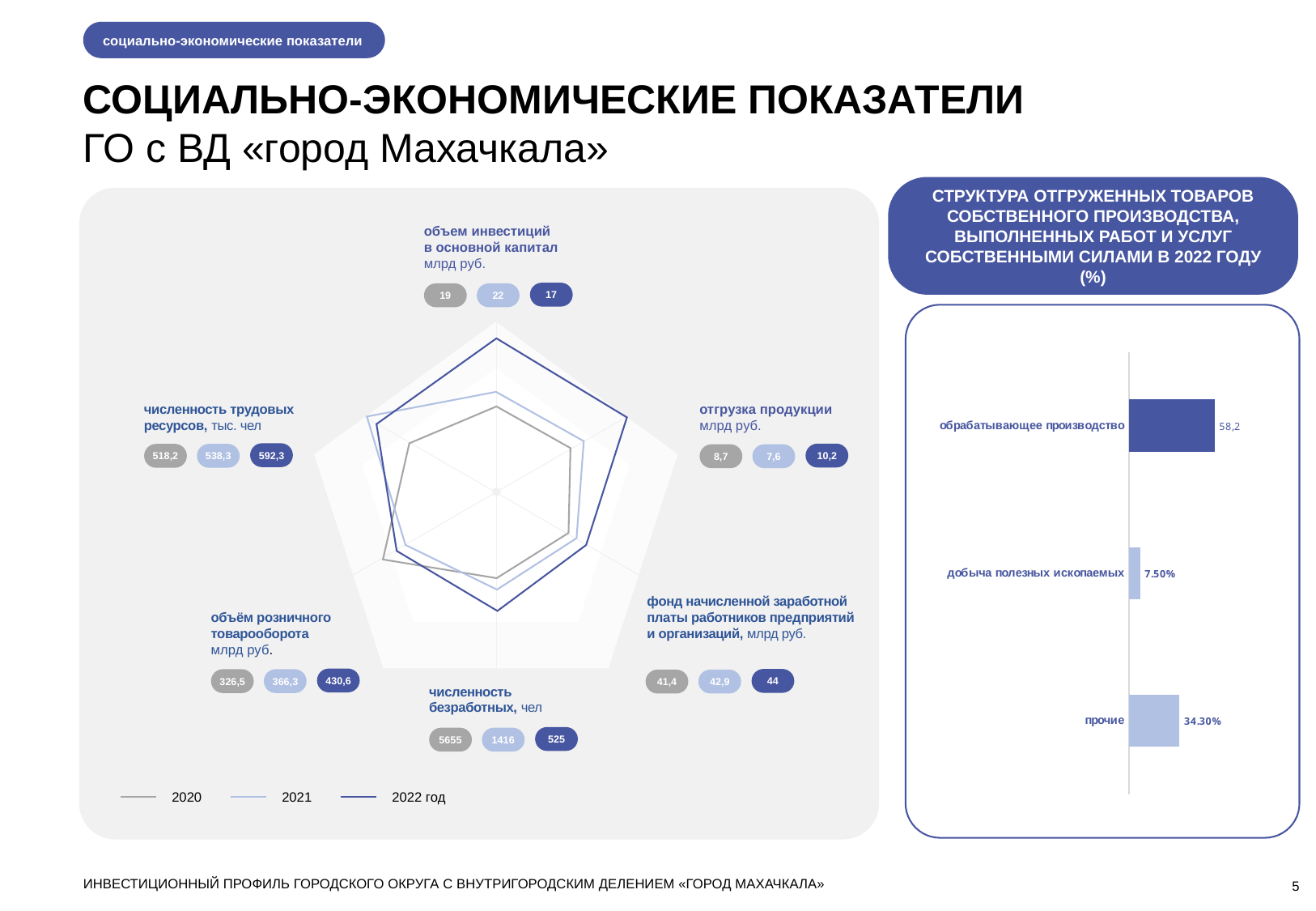
What kind of chart is the one on the right of the slide? bar chart On the right-hand bar chart, which category has the highest value? обрабатывающее производство What kind of chart is the one on the left of the slide? radar chart On the right-hand bar chart, what is the value for обрабатывающее производство? 58,2 How many categories are shown on the right-hand bar chart? 3 On the right-hand bar chart, what is the value for прочие? 34.30% How many indicators (axes) does the left-hand radar chart have? 6 On the left-hand radar chart, what is the value of численность безработных for 2022? 525 How many series does the legend of the left-hand radar chart list? 3 On the left-hand radar chart, what is the difference between the 2022 and 2020 values of объём розничного товарооборота? 104,1 On the right-hand bar chart, which category has the lowest value? добыча полезных ископаемых On the left-hand radar chart, does численность безработных rise or fall from 2020 to 2022? fall